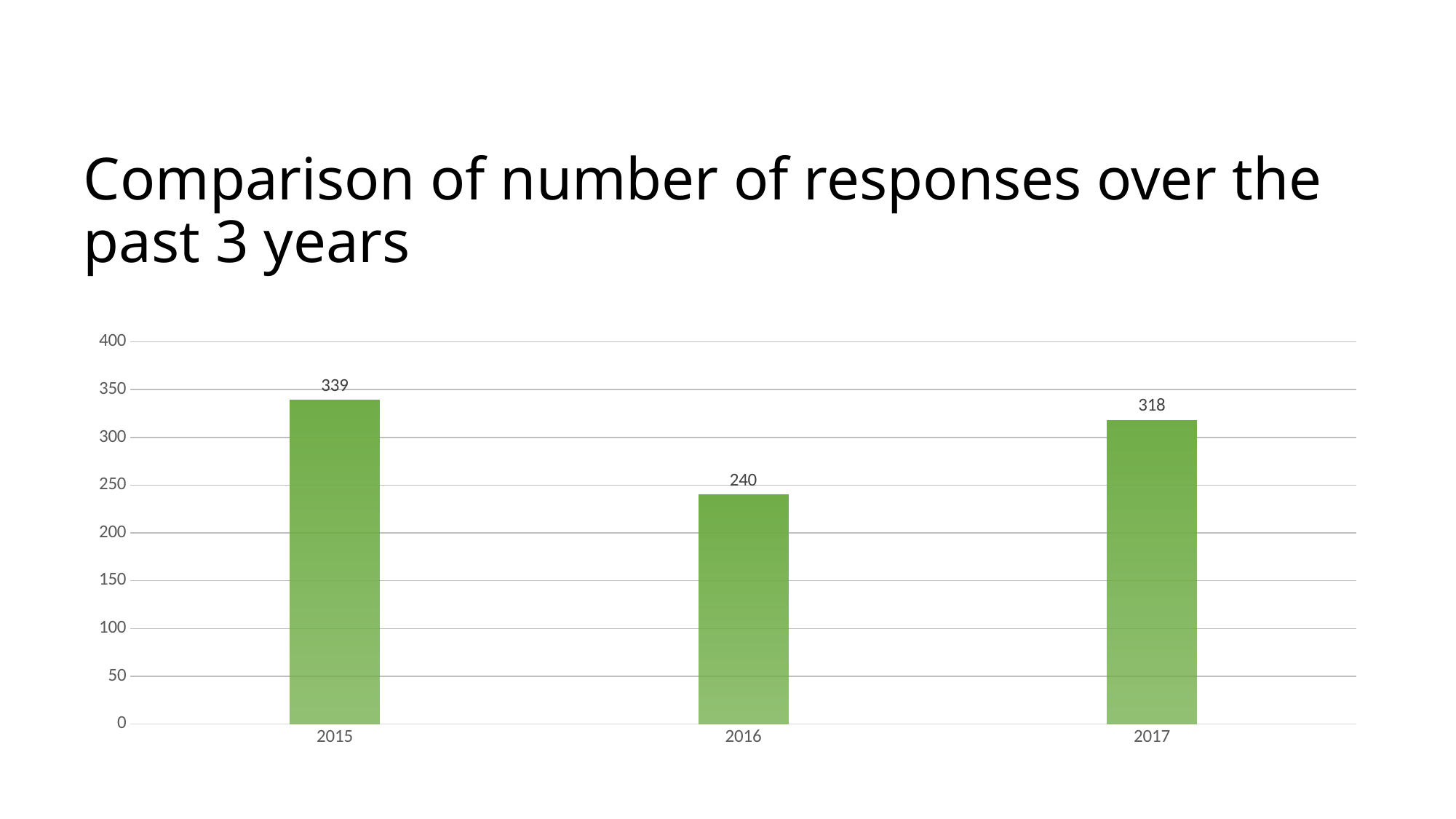
What is the number of responses for 2015? 339 Which year has the highest number of responses? 2015 What is the title of the slide? Comparison of number of responses over the past 3 years What is the number of responses for 2017? 318 Which year has the lowest number of responses? 2016 How many years are shown on the chart? 3 What is the difference between the number of responses in 2015 and 2016? 99 Which year has more responses, 2015 or 2017? 2015 What kind of chart is shown on the slide? bar chart Is the value for 2016 greater or less than 250? less What is the difference between the number of responses in 2017 and 2016? 78 What is the number of responses for 2016? 240